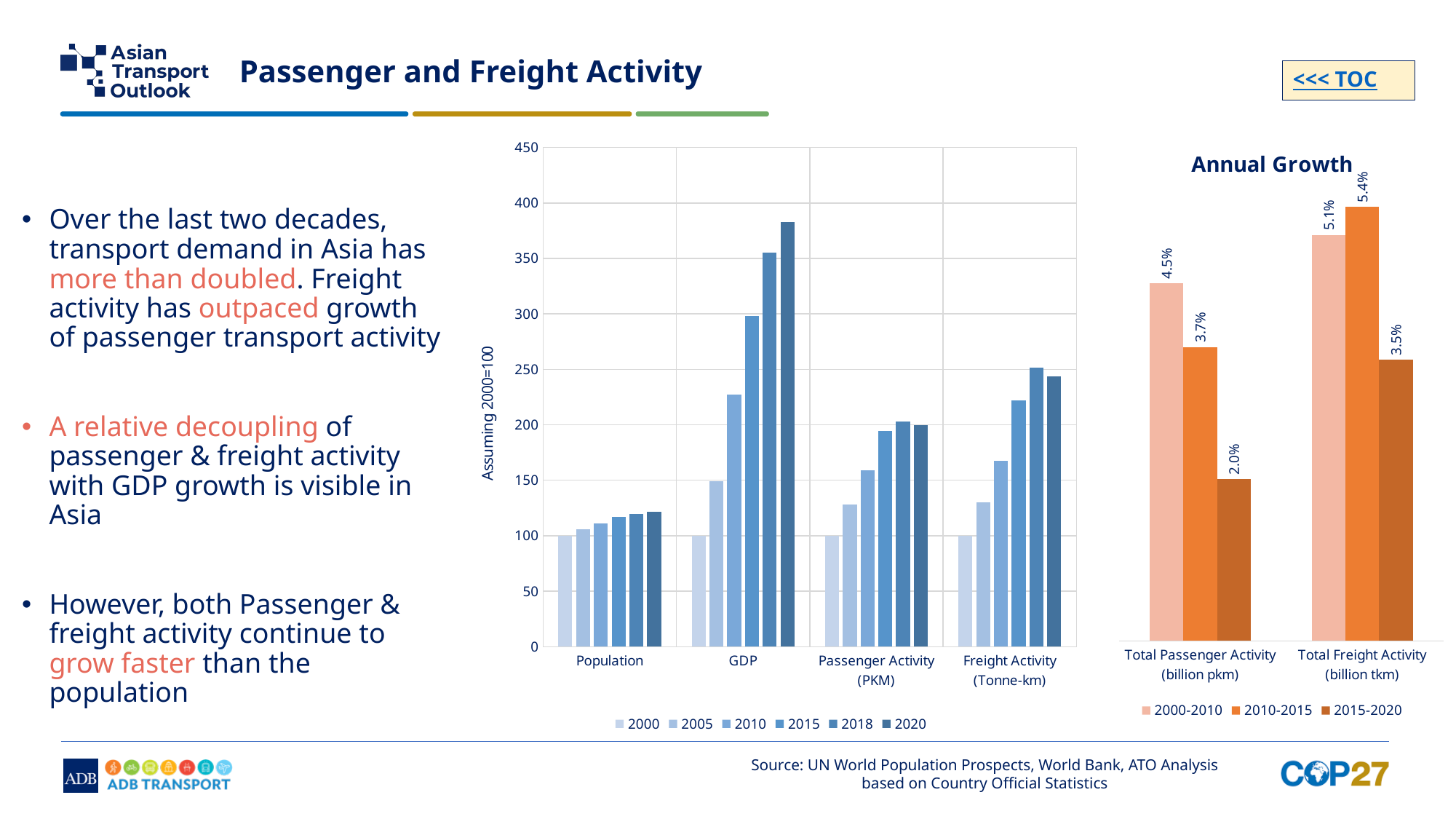
In the left chart (Assuming 2000=100), is the value for Population in 2020 greater or less than 150? less In the Annual Growth chart, what is the difference between the 2000-2010 and 2015-2020 annual growth for Total Passenger Activity? 2.5% In the Annual Growth chart, what is the annual growth for Total Freight Activity in 2015-2020? 3.5% In the Annual Growth chart, what is the annual growth for Total Freight Activity in 2010-2015? 5.4% In the Annual Growth chart, which period has the highest annual growth for Total Freight Activity? 2010-2015 In the Annual Growth chart, what is the annual growth for Total Passenger Activity in 2000-2010? 4.5% What kind of chart is the left chart (Assuming 2000=100)? bar chart In the left chart (Assuming 2000=100), how many series does the legend list? 6 In the Annual Growth chart, which period has the lowest annual growth for Total Passenger Activity? 2015-2020 In the Annual Growth chart, which is larger in 2010-2015: Total Passenger Activity or Total Freight Activity? Total Freight Activity In the left chart (Assuming 2000=100), is the value for GDP in 2020 greater or less than 350? greater How many series does the legend of the Annual Growth chart list? 3